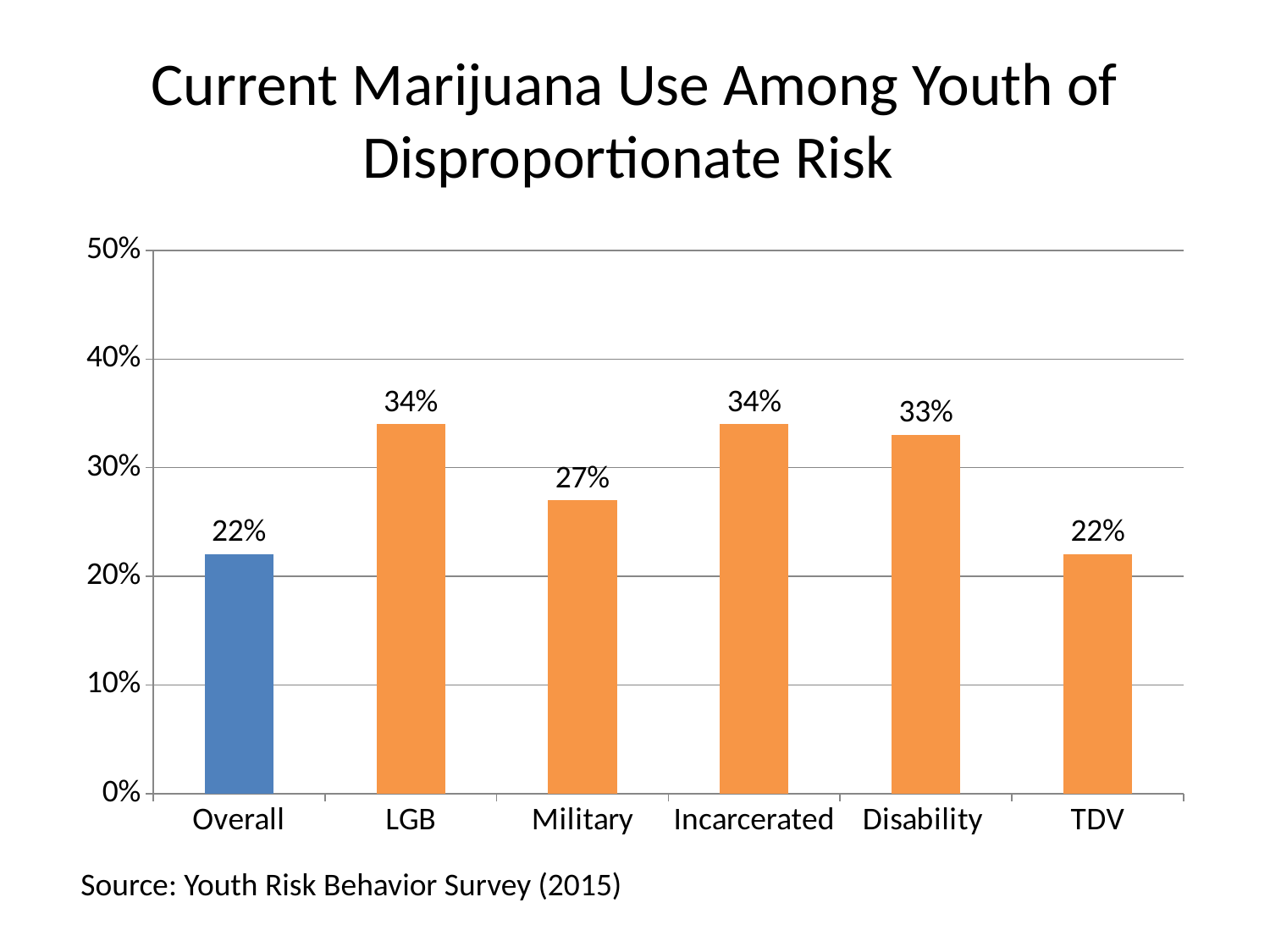
Which category has the lowest value, Military or TDV? TDV What is the value for Overall? 22% Is the value for Military greater or less than 30%? less Is the value for Disability greater or less than 30%? greater What is the value for LGB? 34% What is the value for Disability? 33% What is the value for Military? 27% What is the title of the chart? Current Marijuana Use Among Youth of Disproportionate Risk What is the difference between the values for LGB and Military? 7% How many categories are shown on the x axis? 6 What kind of chart is shown on the slide? bar chart What is the difference between the values for Incarcerated and Overall? 12%